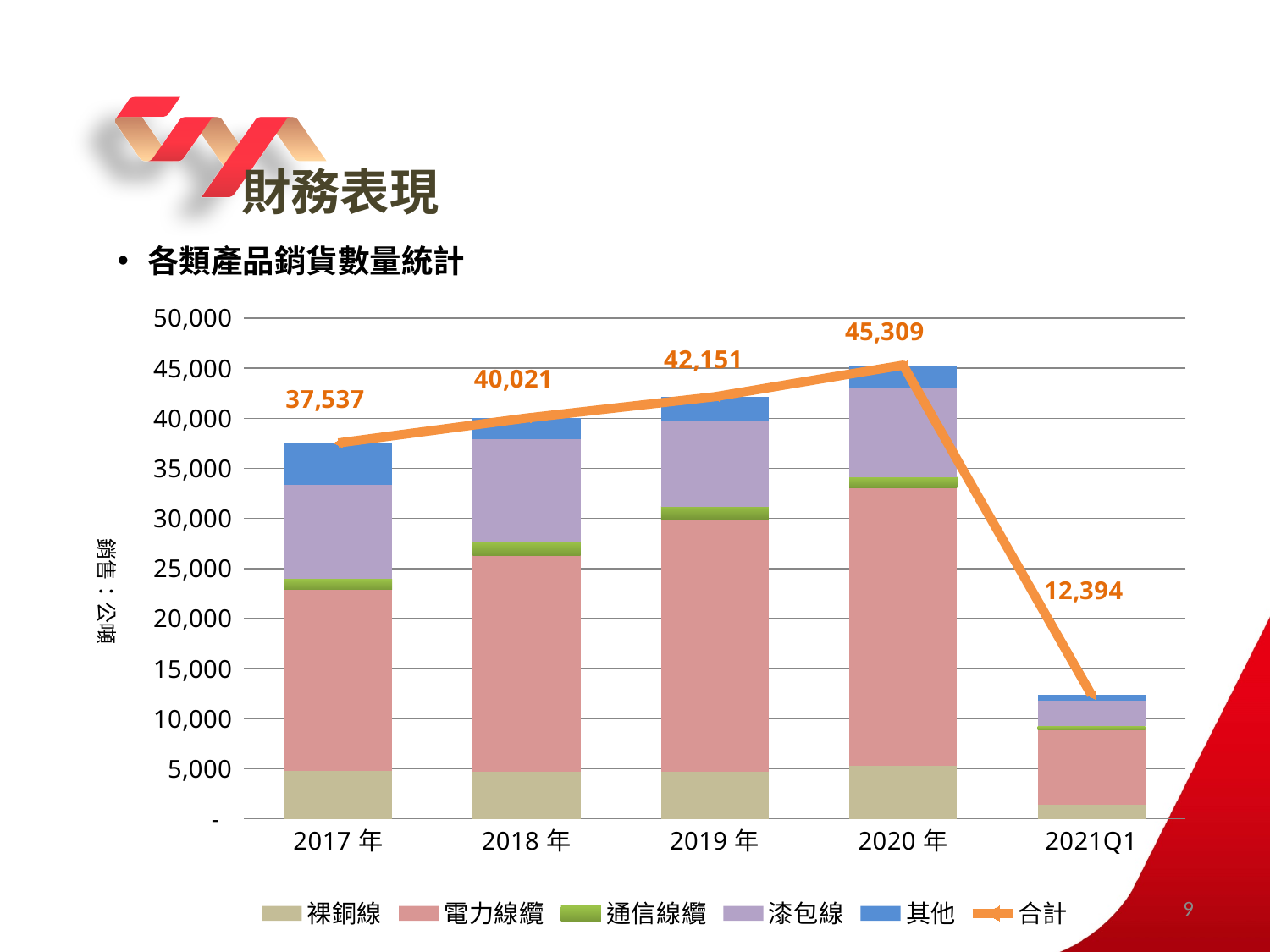
Which period has the lowest total (合計) value? 2021Q1 Is the 電力線纜 segment for 2020 年 greater or less than 30,000? less How many entries does the legend list? 6 Which is larger, the total for 2018 年 or the total for 2019 年? 2019 年 What is the total (合計) value shown for 2020 年? 45,309 What is the total (合計) value shown for 2017 年? 37,537 What is the total (合計) value shown for 2021Q1? 12,394 What is the difference between the total for 2020 年 and the total for 2019 年? 3,158 Which period has the highest total (合計) value? 2020 年 What kind of chart is this? Stacked bar chart with a line Do the total (合計) values rise or fall from 2017 年 to 2020 年? rise How many periods are shown on the x axis? 5